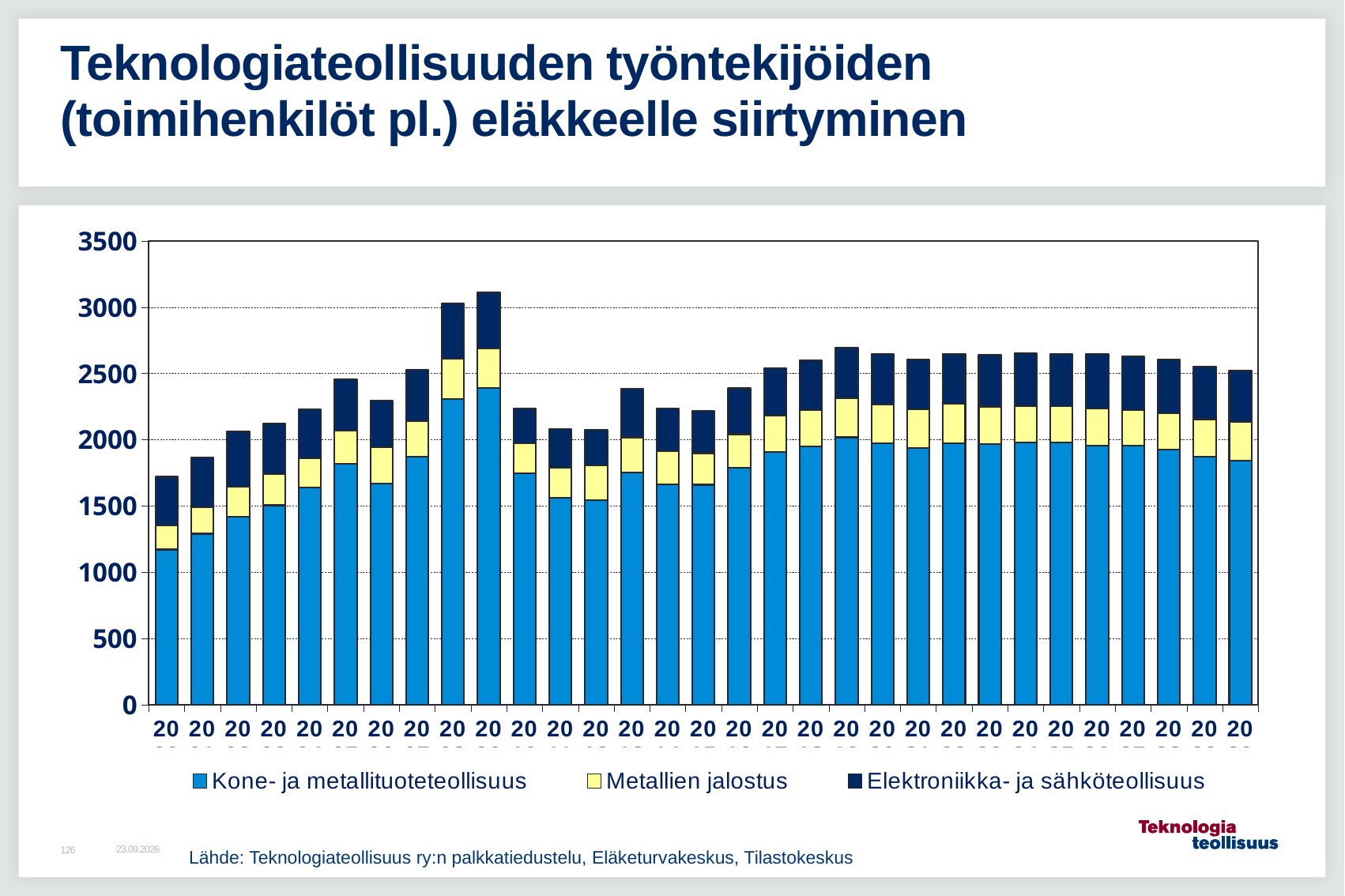
Is the total of the rightmost bar greater or less than 2000? greater Which series forms the bottom segment of each stacked bar? Kone- ja metallituoteteollisuus What is the highest value shown on the vertical axis? 3500 Which is larger, the total of the leftmost bar or the total of the rightmost bar? the rightmost bar How many series does the legend list? 3 Is the total of the leftmost bar greater or less than 2000? less Is the total of the tallest bar greater or less than 3000? greater Do the bar totals rise or fall from the leftmost bar to the tallest bar? rise Which series is shown in dark blue in the legend? Elektroniikka- ja sähköteollisuus How many bars are plotted in the chart? 31 What kind of chart is shown on the slide? Stacked bar chart